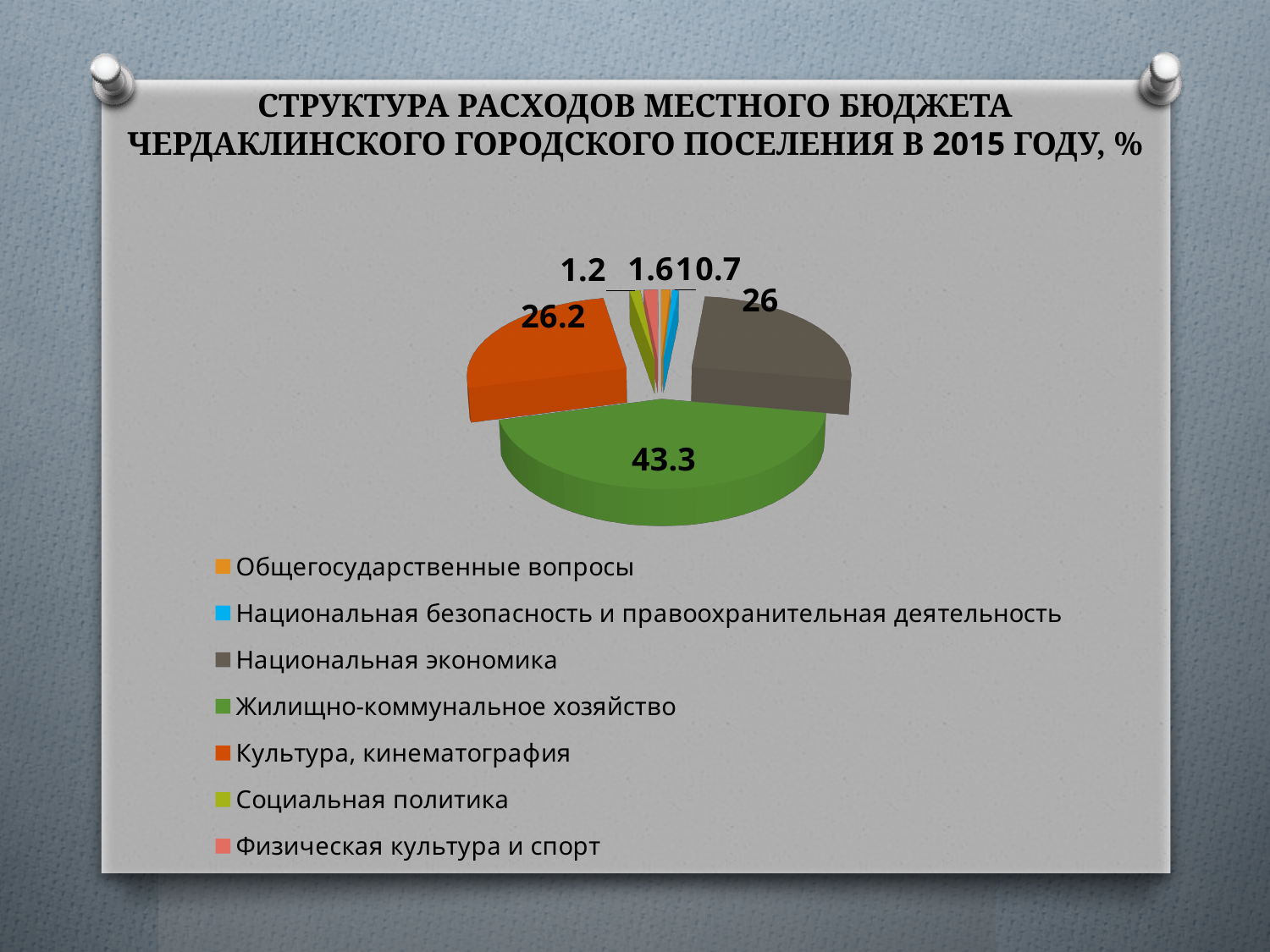
What type of chart is shown on the slide? pie chart What is the smallest value labelled on the pie chart? 0.7 What is the value for Жилищно-коммунальное хозяйство? 43.3 How many categories does the legend list? 7 Which is larger: the value for Жилищно-коммунальное хозяйство or the value for Культура, кинематография? Жилищно-коммунальное хозяйство What colour is the slice for Жилищно-коммунальное хозяйство? green What is the value for Национальная экономика? 26 What year does the chart title refer to? 2015 What is the difference between the values for Жилищно-коммунальное хозяйство and Национальная экономика? 17.3 What is the value for Культура, кинематография? 26.2 Which category has the largest share of the pie? Жилищно-коммунальное хозяйство What is the difference between the values for Культура, кинематография and Национальная экономика? 0.2